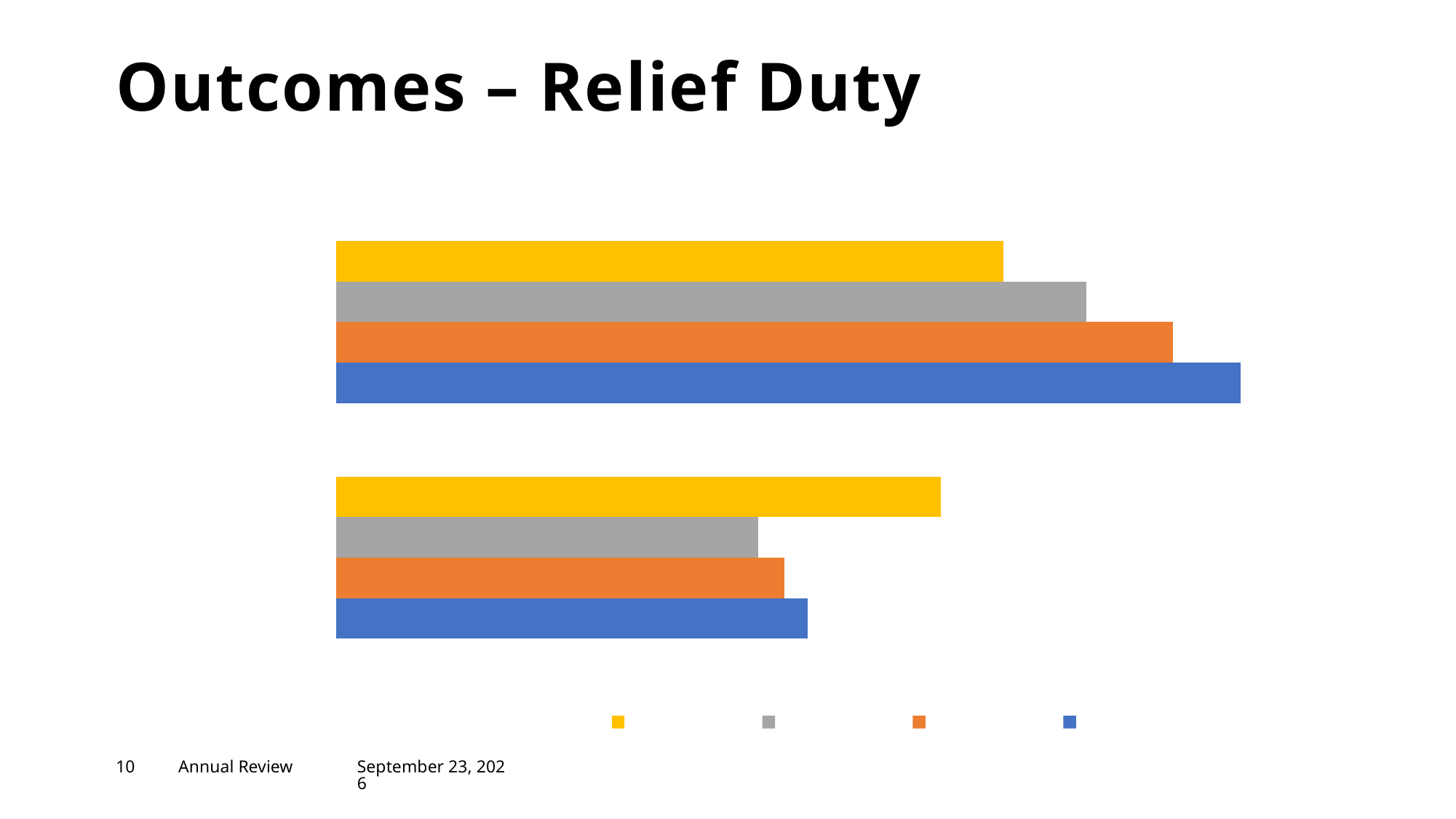
In the bottom group, is the gray bar longer or shorter than the yellow bar? shorter How many series does the legend show? 4 Are the bars in the chart horizontal or vertical? horizontal What is the title of the slide containing the chart? Outcomes – Relief Duty In the top group of bars, which colour bar is the shortest? yellow What kind of chart is shown on the slide? bar chart In the top group, is the blue bar longer or shorter than the yellow bar? longer In the bottom group of bars, which colour bar is the longest? yellow In the top group of bars, which colour bar is the longest? blue In the bottom group of bars, which colour bar is the shortest? gray How many groups of bars are plotted in the chart? 2